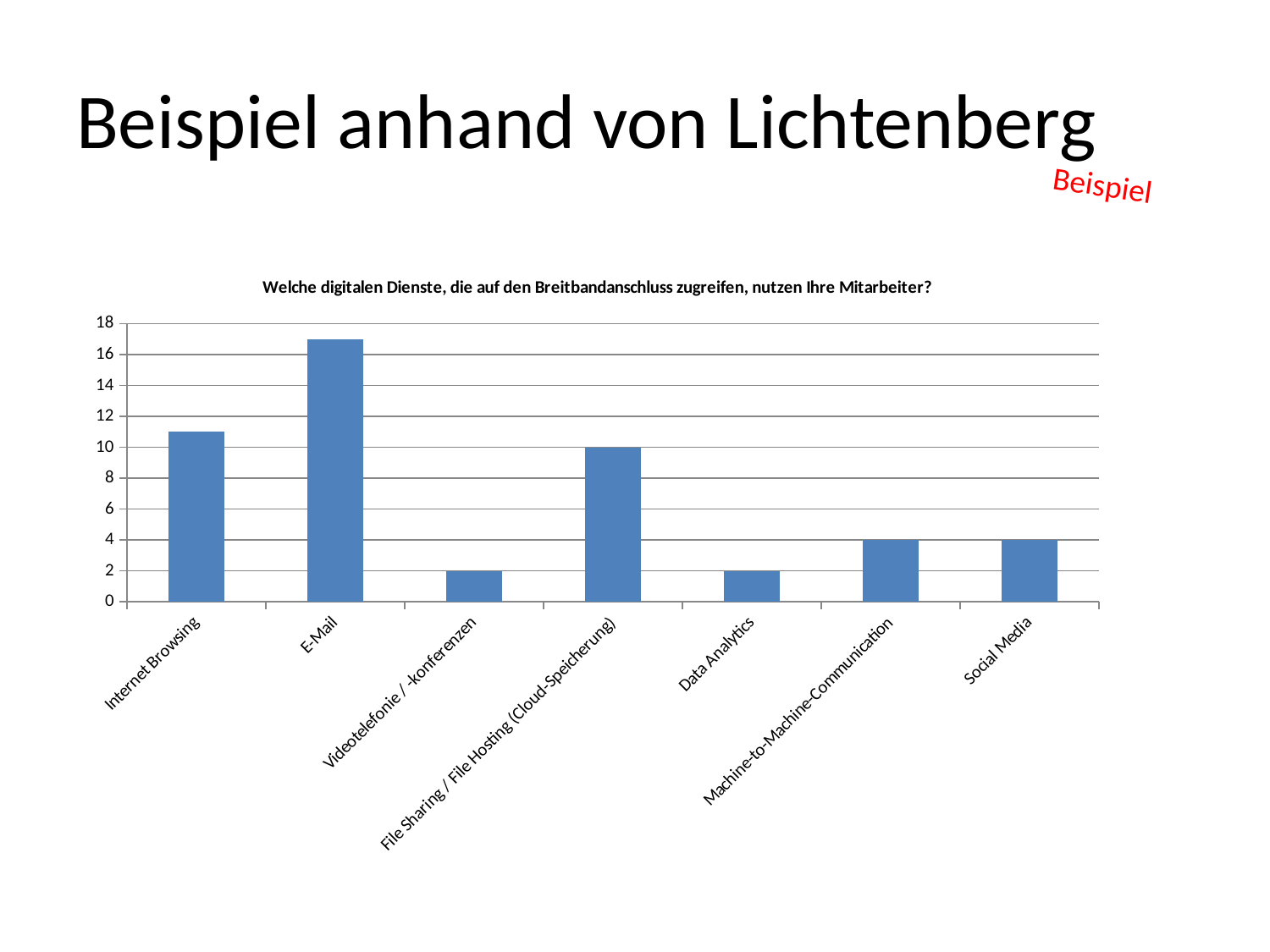
What kind of chart is shown on the slide? bar chart Which is larger, the value for E-Mail or the value for Internet Browsing? E-Mail Is the value for Internet Browsing greater or less than 12? less What is the value for Machine-to-Machine-Communication? 4 How many categories are shown on the x axis of the chart? 7 What is the value for Data Analytics? 2 Which category has the highest value in the chart? E-Mail What is the difference between the value for File Sharing / File Hosting (Cloud-Speicherung) and the value for Social Media? 6 What is the title of the chart? Welche digitalen Dienste, die auf den Breitbandanschluss zugreifen, nutzen Ihre Mitarbeiter? Is the value for E-Mail greater or less than 16? greater What is the value for File Sharing / File Hosting (Cloud-Speicherung)? 10 What is the value for Social Media? 4